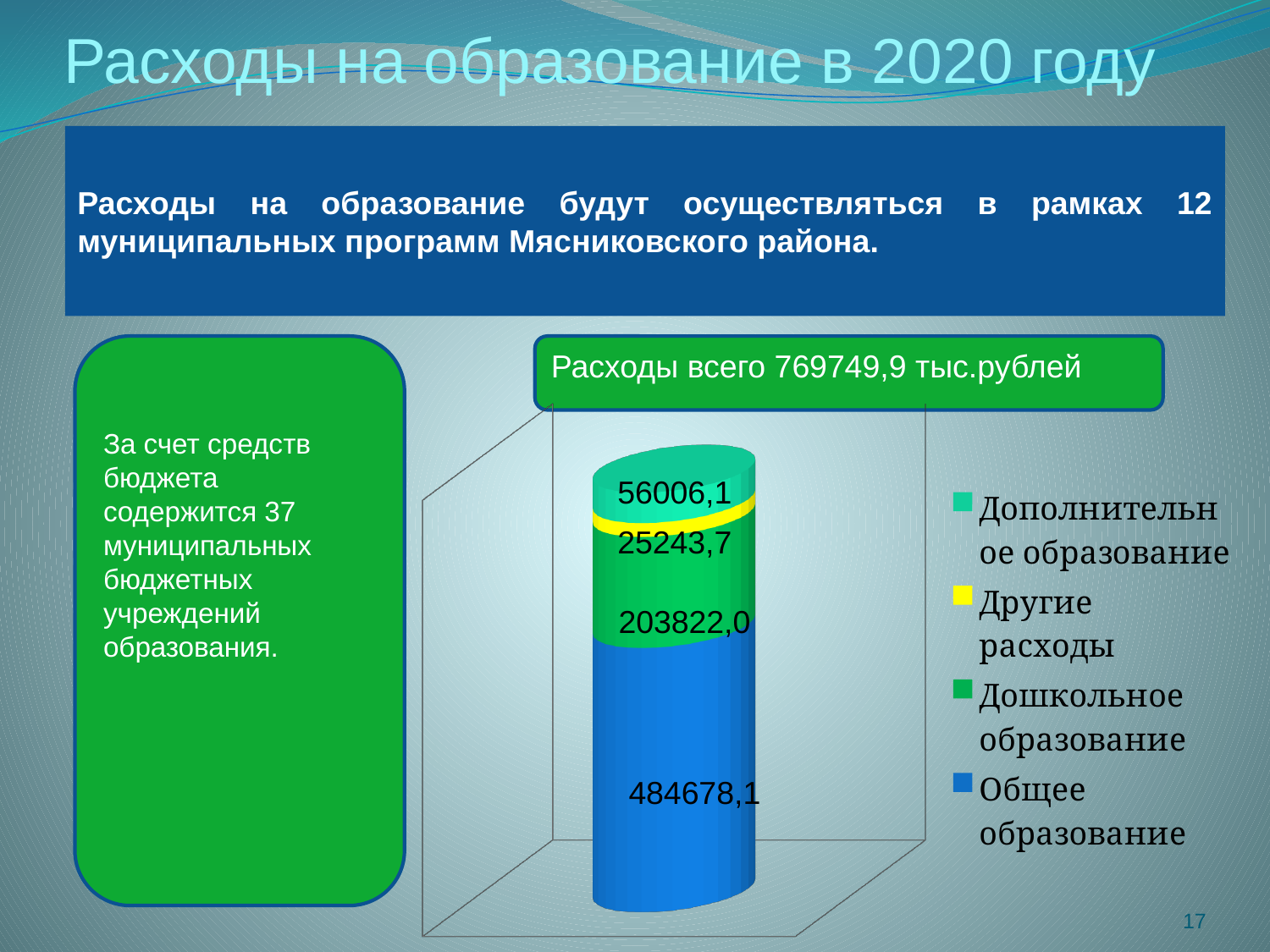
What is the value for Другие расходы in the chart? 25243,7 Which is larger, the value for Дополнительное образование or the value for Другие расходы? Дополнительное образование What is the value for Общее образование in the chart? 484678,1 What kind of chart is shown on the slide? Stacked bar chart Which series has the smallest value in the stacked bar? Другие расходы What is the value for Дополнительное образование in the chart? 56006,1 Which colour represents Другие расходы in the legend? Yellow What is the difference between the values for Общее образование and Дошкольное образование? 280856,1 How many series does the legend list? 4 What is the value for Дошкольное образование in the chart? 203822,0 What is the total of all segments in the stacked bar? 769749,9 Which series has the largest value in the stacked bar? Общее образование